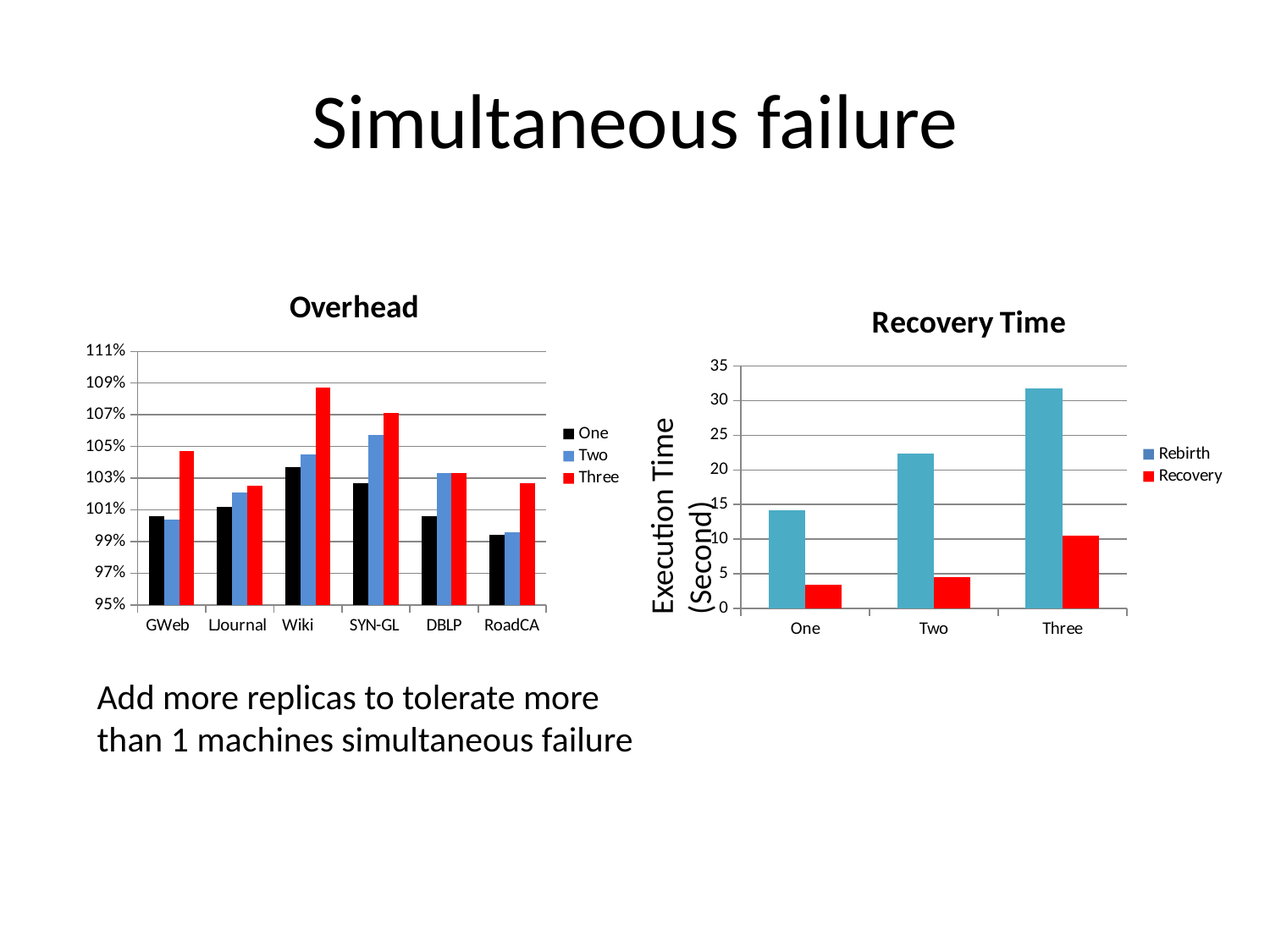
How many series does the legend of the Overhead chart list? 3 In the Recovery Time chart, is the Recovery value for One greater or less than 5? less In the Overhead chart, is the value for Wiki in the Three series greater or less than 107%? greater In the Overhead chart, is the value for RoadCA in the One series greater or less than 101%? less How many categories are shown on the x axis of the Overhead chart? 6 What kind of chart is the Overhead chart? bar chart In the Recovery Time chart, do the Rebirth values rise or fall from One to Three? rise What is the y-axis label of the Recovery Time chart? Execution Time (Second) In the Overhead chart, which category has the highest value for the Three series? Wiki How many series does the legend of the Recovery Time chart list? 2 In the Overhead chart, which is larger for the Two series: SYN-GL or GWeb? SYN-GL